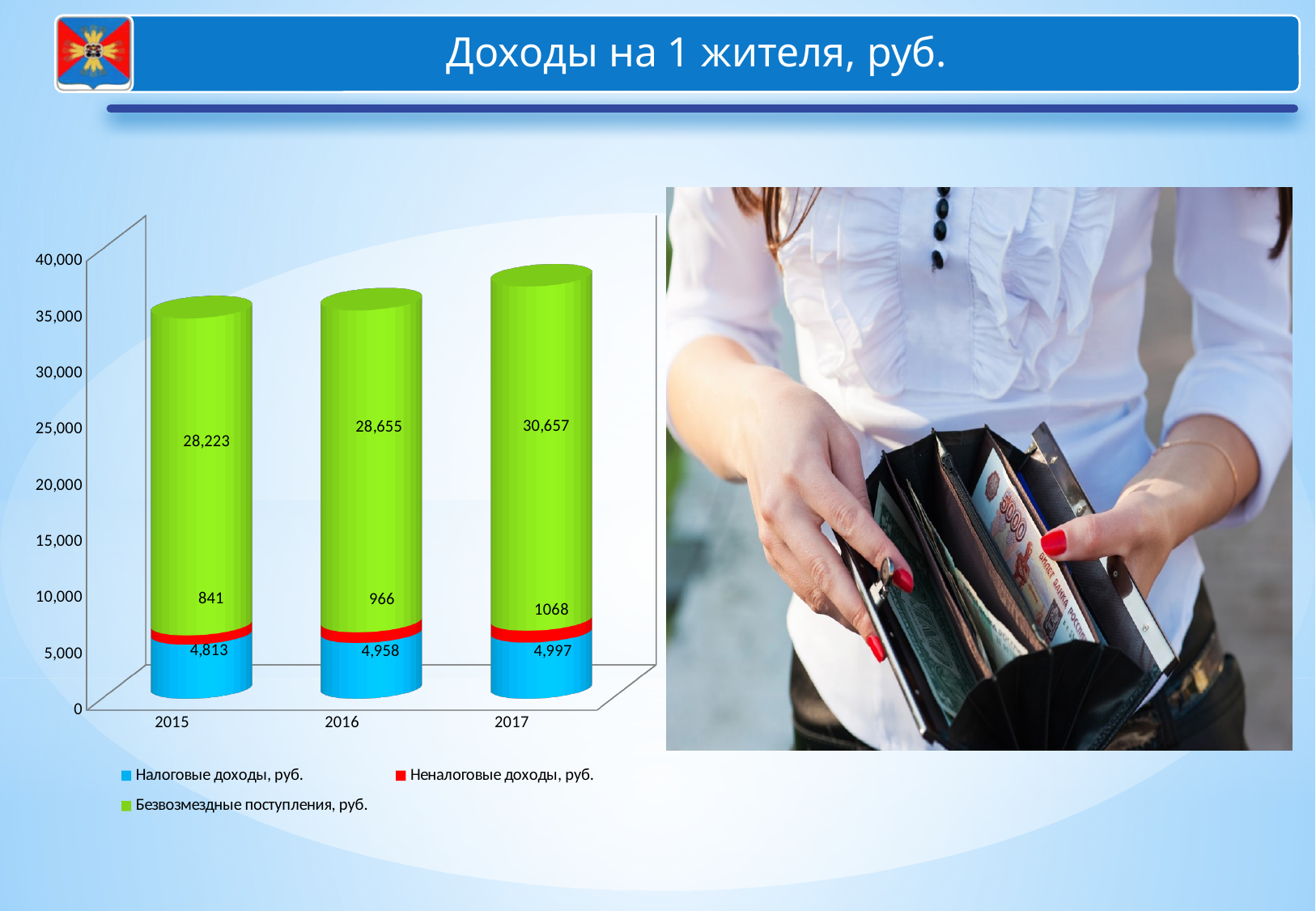
How many series does the legend list? 3 In which year is Безвозмездные поступления, руб. the highest? 2017 Which is larger: Налоговые доходы, руб. in 2016 or in 2015? 2016 In which year is Неналоговые доходы, руб. the lowest? 2015 What is the difference between Безвозмездные поступления, руб. in 2017 and in 2016? 2,002 What is the value of Неналоговые доходы, руб. for 2016? 966 How many years are shown on the x axis? 3 Do the values of Безвозмездные поступления, руб. rise or fall from 2015 to 2017? rise What is the total of the stacked bar for 2015? 33,877 What is the value of Безвозмездные поступления, руб. for 2017? 30,657 What is the value of Налоговые доходы, руб. for 2015? 4,813 What is the value of Неналоговые доходы, руб. for 2017? 1068